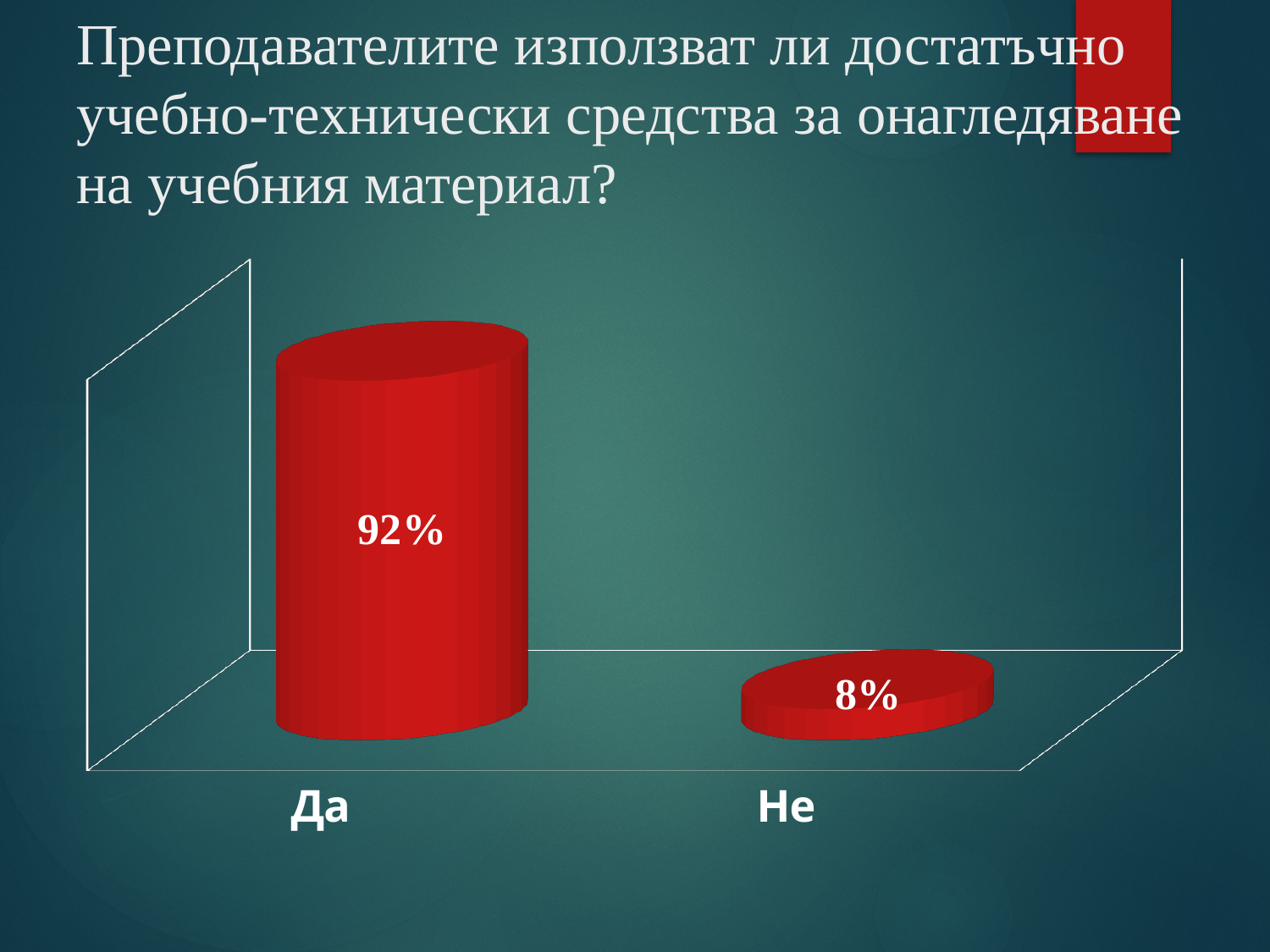
Which category has the lowest value? Не What is the difference between the values for "Да" and "Не"? 84% How many categories are shown in the chart? 2 What colour are the bars in the chart? Red Which category has the highest value? Да What is the value for "Не"? 8% What is the label of the first category on the x axis? Да What is the total of the two values shown in the chart? 100% What kind of chart is shown on the slide? Bar chart What is the value for "Да"? 92% Which is larger, the value for "Да" or the value for "Не"? Да